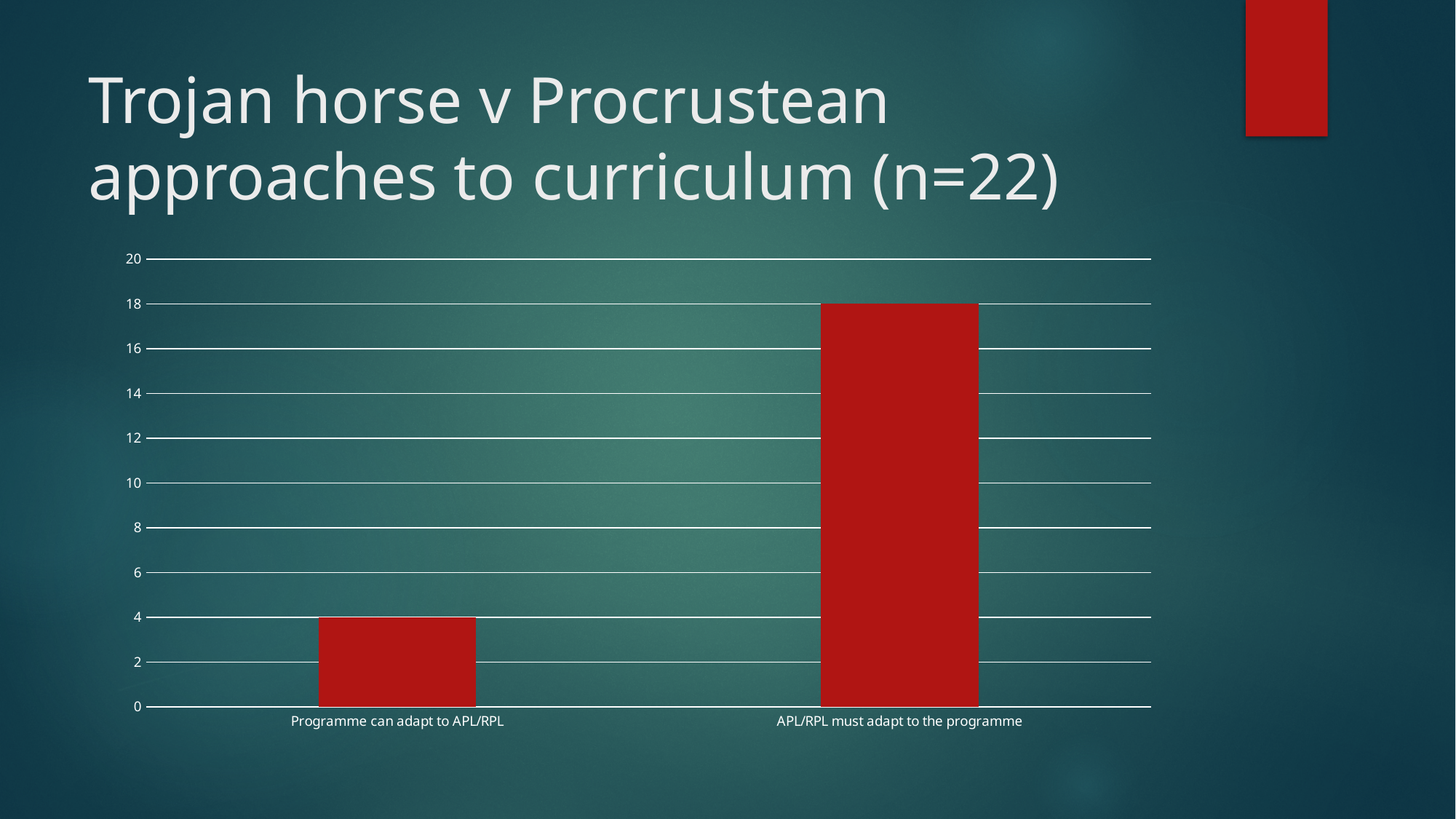
What is the value for "Programme can adapt to APL/RPL"? 4 How many categories are shown on the x axis? 2 Is the value for "Programme can adapt to APL/RPL" greater or less than 10? less What is the title of the slide containing the chart? Trojan horse v Procrustean approaches to curriculum (n=22) Which is larger: the value for "Programme can adapt to APL/RPL" or the value for "APL/RPL must adapt to the programme"? APL/RPL must adapt to the programme Which category has the highest value? APL/RPL must adapt to the programme Is the value for "APL/RPL must adapt to the programme" greater or less than 10? greater What is the value for "APL/RPL must adapt to the programme"? 18 Which category has the lowest value? Programme can adapt to APL/RPL What kind of chart is shown on the slide? bar chart What is the difference between the values for "APL/RPL must adapt to the programme" and "Programme can adapt to APL/RPL"? 14 What is the highest value shown on the vertical axis? 20